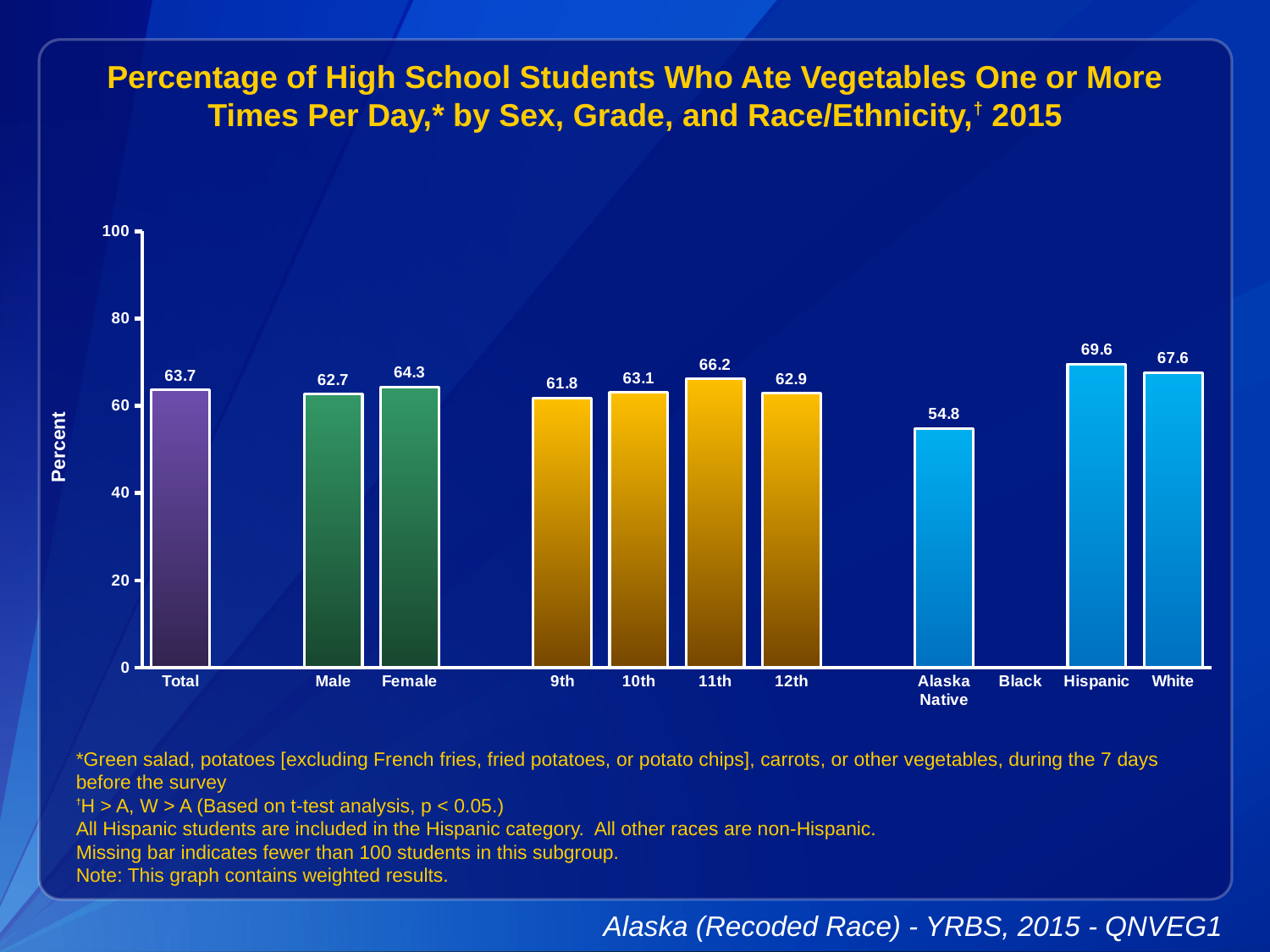
What is the value for 11th grade? 66.2 What is the label of the y axis? Percent Which is larger, the value for Hispanic or the value for White? Hispanic What kind of chart is shown? bar chart What is the value for Female? 64.3 Which category has the highest value? Hispanic What is the value for Total? 63.7 How many bars are plotted on the chart? 10 What is the difference between the Female and Male values? 1.6 Which category has the lowest value? Alaska Native What is the value for Alaska Native? 54.8 Is the value for 9th grade greater or less than 60? greater